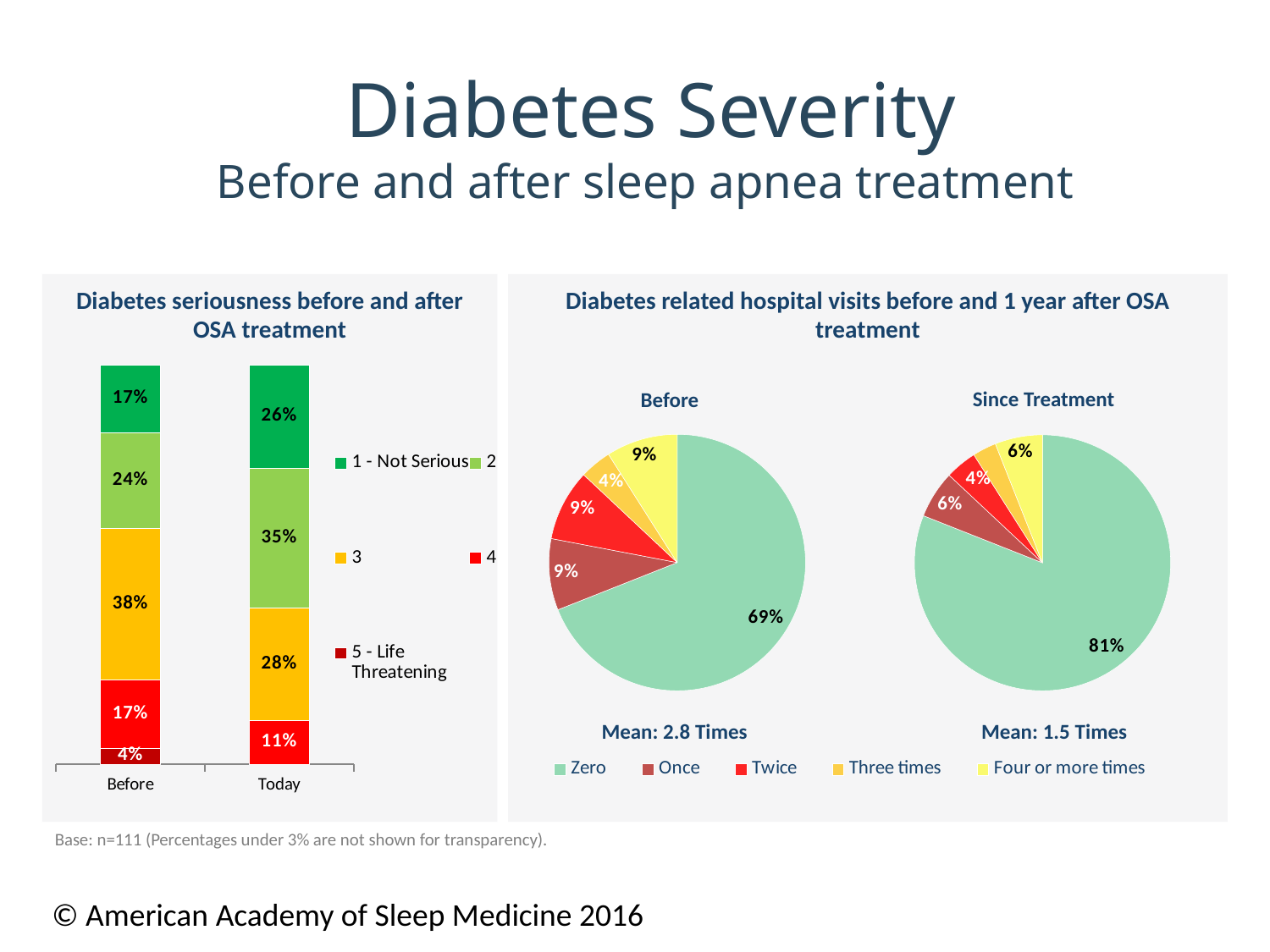
In the 'Since Treatment' pie chart of diabetes related hospital visits, what share is labelled for Zero visits? 81% In the 'Before' pie chart of diabetes related hospital visits, what share is labelled for 'Four or more times'? 9% In the stacked bar chart 'Diabetes seriousness before and after OSA treatment', by how many percentage points does the rating 3 segment differ between Before (38%) and Today (28%)? 10 percentage points In the 'Before' pie chart of diabetes related hospital visits, what share is labelled for Zero visits? 69% In the stacked bar chart 'Diabetes seriousness before and after OSA treatment', is the '1 - Not Serious' segment larger for Before or for Today? Today How many series does the legend of the stacked bar chart 'Diabetes seriousness before and after OSA treatment' list? 5 What kind of chart is 'Diabetes seriousness before and after OSA treatment'? Stacked bar chart In the stacked bar chart 'Diabetes seriousness before and after OSA treatment', what percentage is shown for '1 - Not Serious' in the Today bar? 26% In the stacked bar chart 'Diabetes seriousness before and after OSA treatment', what percentage is shown for rating 3 in the Before bar? 38% In the 'Before' pie chart of diabetes related hospital visits, which category has the largest slice? Zero What mean number of hospital visits is shown under the 'Since Treatment' pie chart? 1.5 Times In the stacked bar chart 'Diabetes seriousness before and after OSA treatment', what percentage is shown for '5 - Life Threatening' in the Before bar? 4%